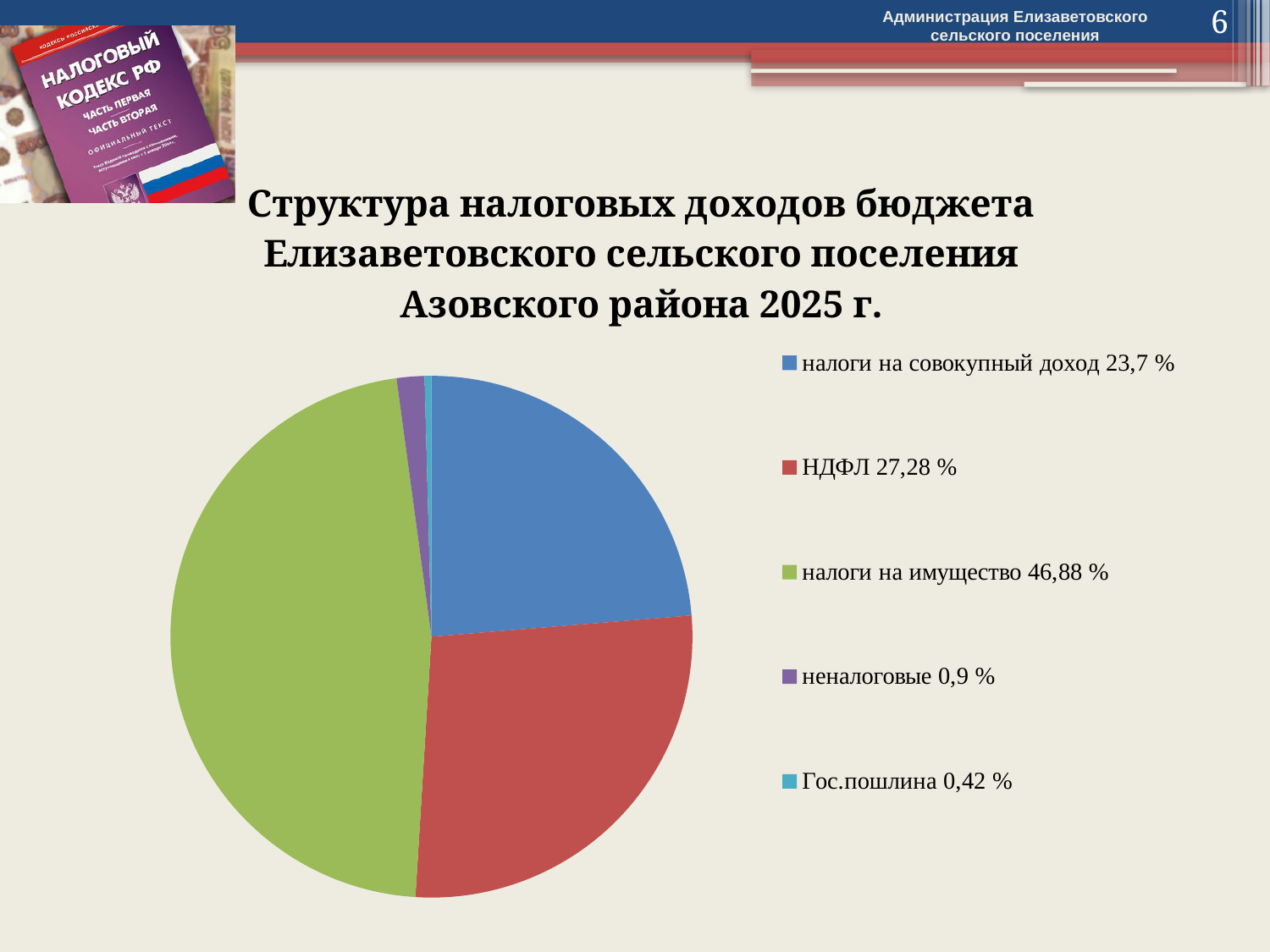
How many slices does the pie chart have? 5 What is the value shown for налоги на совокупный доход? 23,7 % Which category has the smallest share of the pie? Гос.пошлина What colour is the slice for налоги на имущество? green What share of the pie does НДФЛ account for? 27,28 % Which category has the largest share of the pie? налоги на имущество Which is larger: the share of НДФЛ or the share of налоги на совокупный доход? НДФЛ What is the difference between the shares of налоги на имущество and НДФЛ? 19,6 % What is the value shown for Гос.пошлина? 0,42 % What is the value shown for неналоговые? 0,9 % What type of chart is shown on the slide? pie chart What year does the chart title refer to? 2025